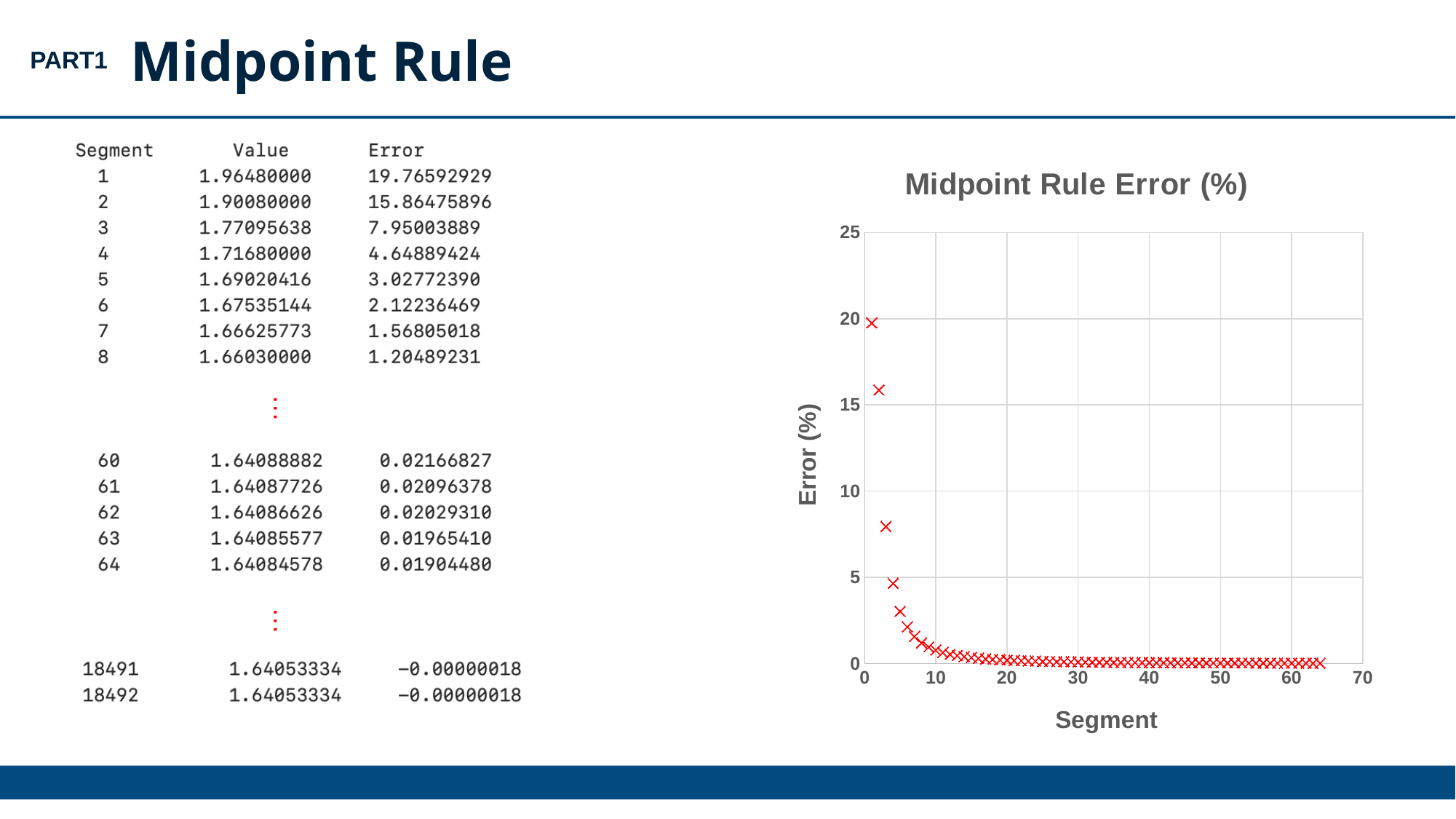
Does the error rise or fall as the segment number increases along the x axis? fall According to the table on the slide, what is the error plotted for segment 1? 19.76592929 Which segment has the highest error in the chart? Segment 1 According to the table on the slide, what is the error plotted for segment 8? 1.20489231 Is the error value for segment 3 greater or less than 10? less What kind of chart is shown on the slide? scatter chart Is the error value for segment 5 greater or less than 5? less Which has the larger error, segment 1 or segment 3? segment 1 What is the title of the chart? Midpoint Rule Error (%) Is the error value for segment 2 greater or less than 20? less What is the label of the vertical axis of the chart? Error (%)